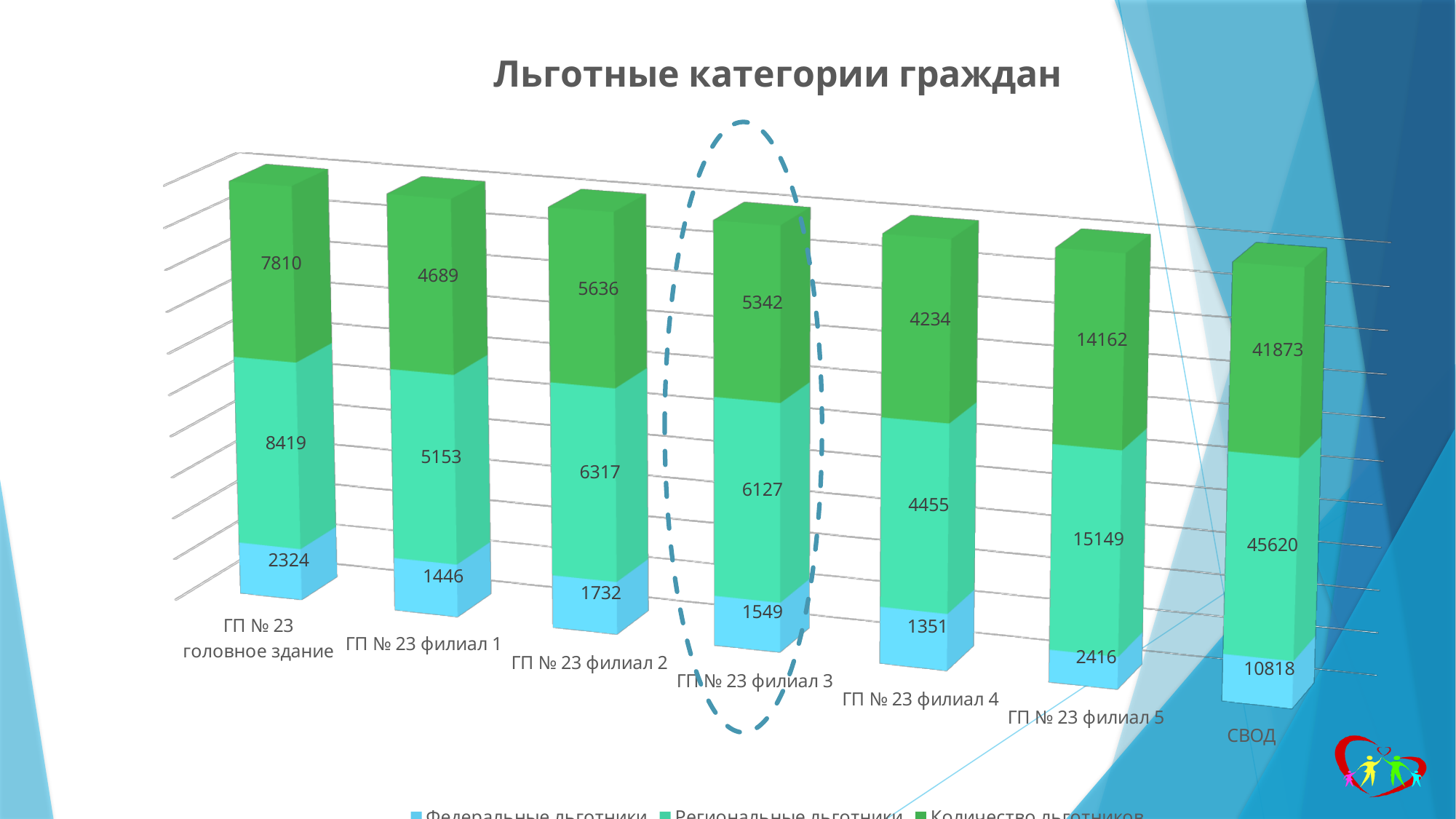
What is the value of Количество льготников for ГП № 23 филиал 5? 14162 How many series does the legend list? 3 How many categories are shown on the x axis? 7 What is the value of Федеральные льготники for ГП № 23 головное здание? 2324 Which category has the lowest value for Федеральные льготники? ГП № 23 филиал 4 Which category has the highest value for Количество льготников? СВОД What is the difference between Региональные льготники and Федеральные льготники for ГП № 23 головное здание? 6095 What type of chart is shown on the slide? Stacked bar chart What is the value of Региональные льготники for СВОД? 45620 What is the value of Региональные льготники for ГП № 23 филиал 3? 6127 What is the difference between Региональные льготники and Количество льготников for СВОД? 3747 Which is larger: Федеральные льготники for ГП № 23 филиал 2 or for ГП № 23 филиал 1? ГП № 23 филиал 2